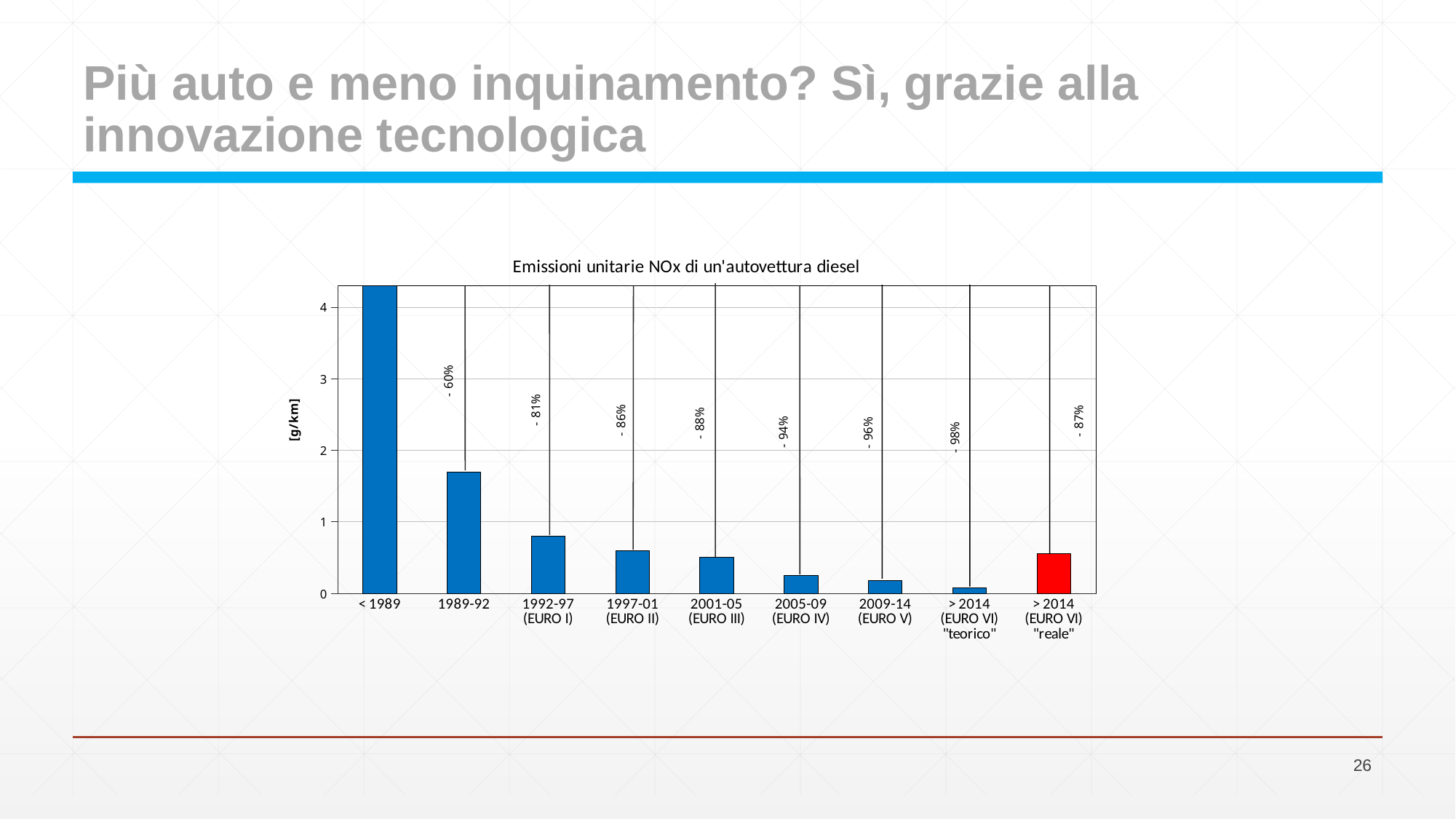
Which is larger, the value for > 2014 (EURO VI) "teorico" or > 2014 (EURO VI) "reale"? > 2014 (EURO VI) "reale" What percentage label is printed above the 1989-92 bar? - 60% Which bar is coloured red instead of blue? > 2014 (EURO VI) "reale" Which category has the highest NOx emission value? < 1989 How many categories are shown on the x axis of the chart? 9 Is the value for 1992-97 (EURO I) greater or less than 1 g/km? less Is the value for < 1989 greater or less than 4 g/km? greater Which category has the lowest NOx emission value? > 2014 (EURO VI) "teorico" What is the title of the chart? Emissioni unitarie NOx di un'autovettura diesel What percentage label is printed above the > 2014 (EURO VI) "reale" bar? - 87% What type of chart is shown on the slide? bar chart What percentage label is printed above the 2009-14 (EURO V) bar? - 96%